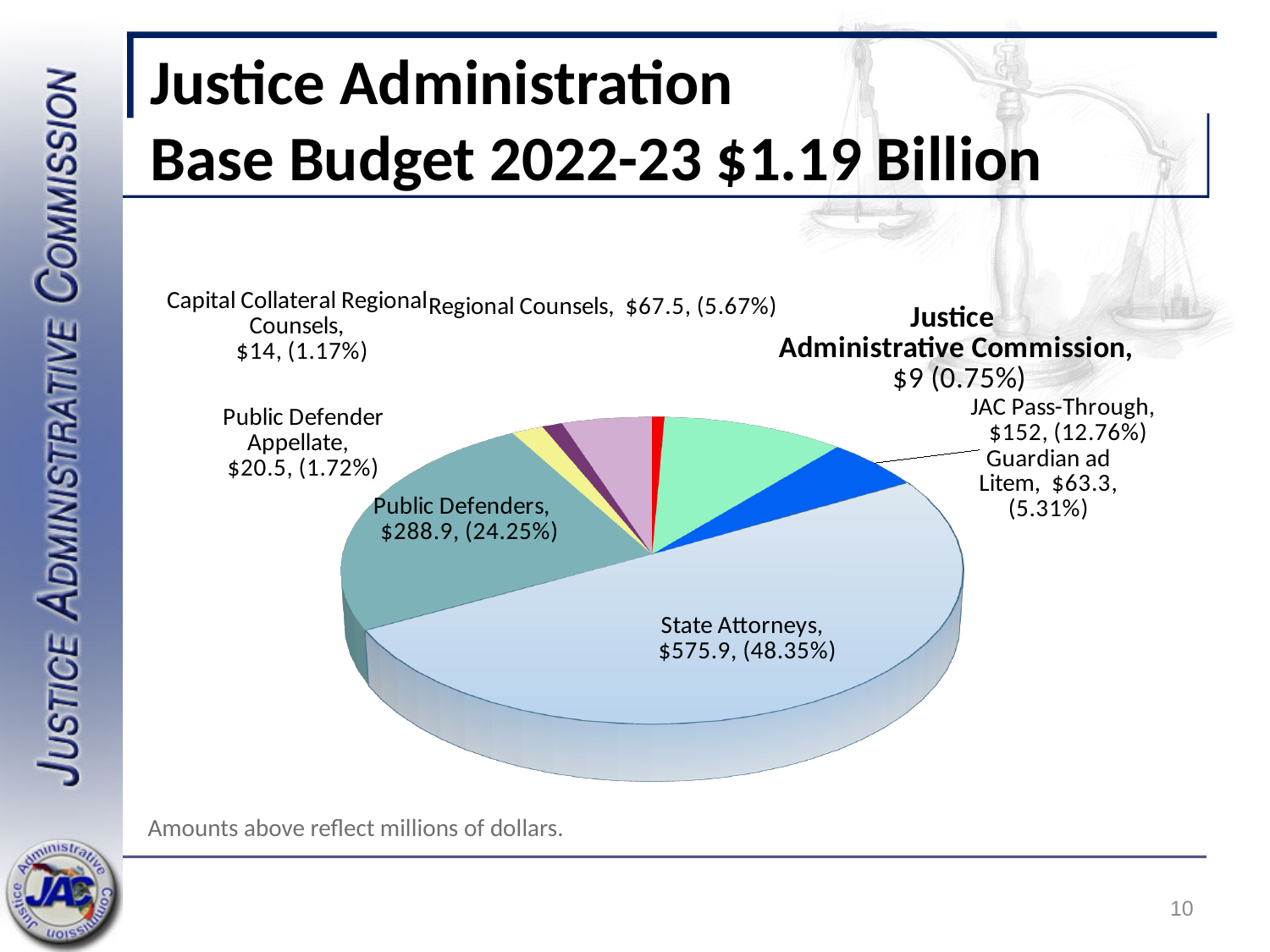
What is the title of the slide containing the chart? Justice Administration Base Budget 2022-23 $1.19 Billion What percentage share is shown for Guardian ad Litem? 5.31% What is the difference between the values for State Attorneys and Public Defenders? $287 How many categories are shown in the pie chart? 8 Which category has the largest slice of the pie? State Attorneys Which category has the smallest slice of the pie? Justice Administrative Commission Which is larger, the value for Regional Counsels or the value for Guardian ad Litem? Regional Counsels What is the value for JAC Pass-Through? $152 What is the value for State Attorneys? $575.9 What type of chart is shown on the slide? pie chart What is the value for Public Defender Appellate? $20.5 What share of the pie does Public Defenders represent? 24.25%